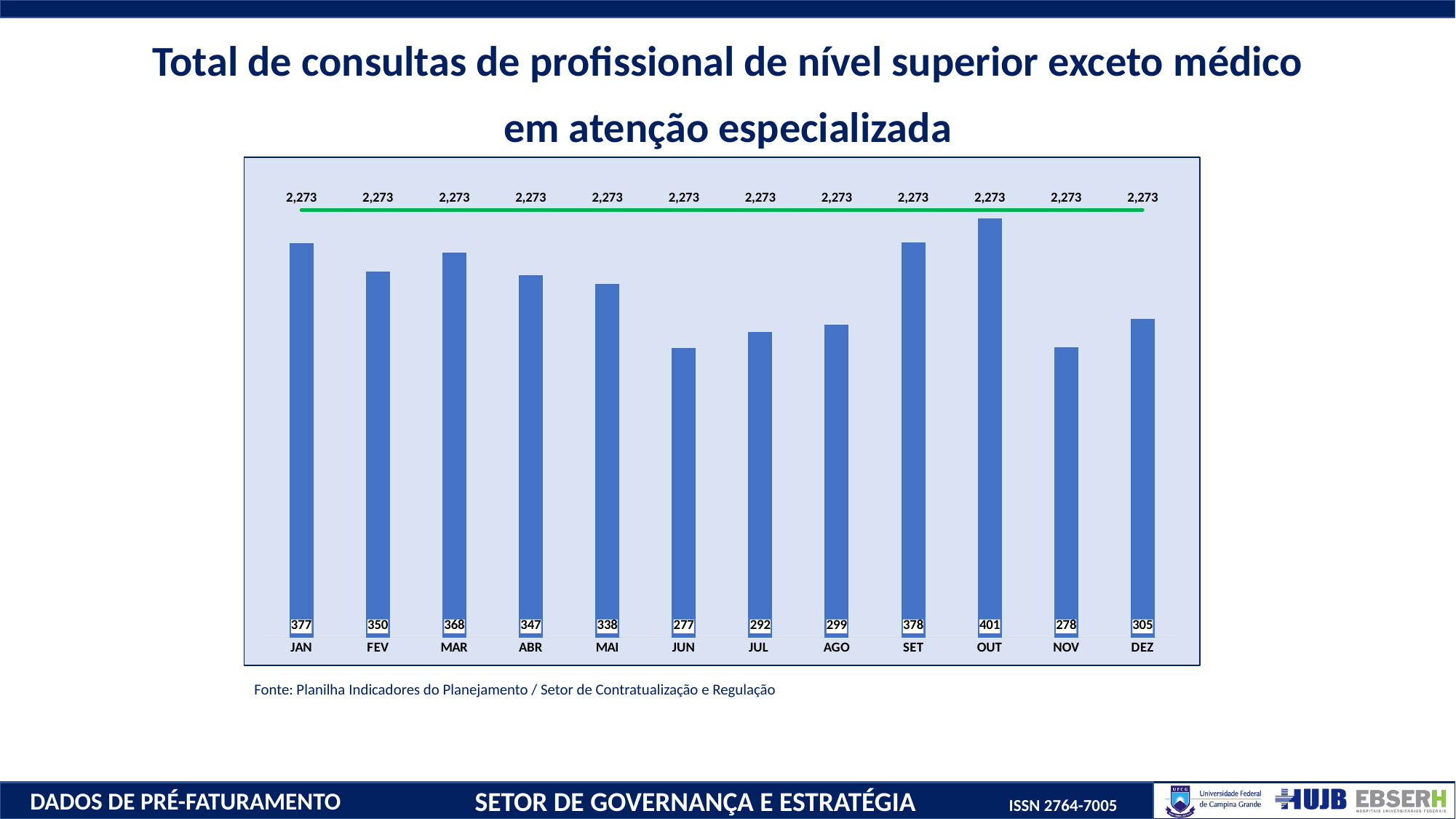
What kind of chart is shown on the slide? Combination bar and line chart What is the difference between the values for JAN and FEV? 27 What value does the green line show for each month? 2,273 What is the value of the bar for OUT? 401 Which month has the lowest bar? JUN What is the title of the chart? Total de consultas de profissional de nível superior exceto médico em atenção especializada Which month has the highest bar? OUT What is the value of the bar for JUN? 277 How many months are shown on the x axis? 12 What is the difference between the values for OUT and JUN? 124 What is the value of the bar for MAR? 368 Which is larger, the value for SET or the value for DEZ? SET